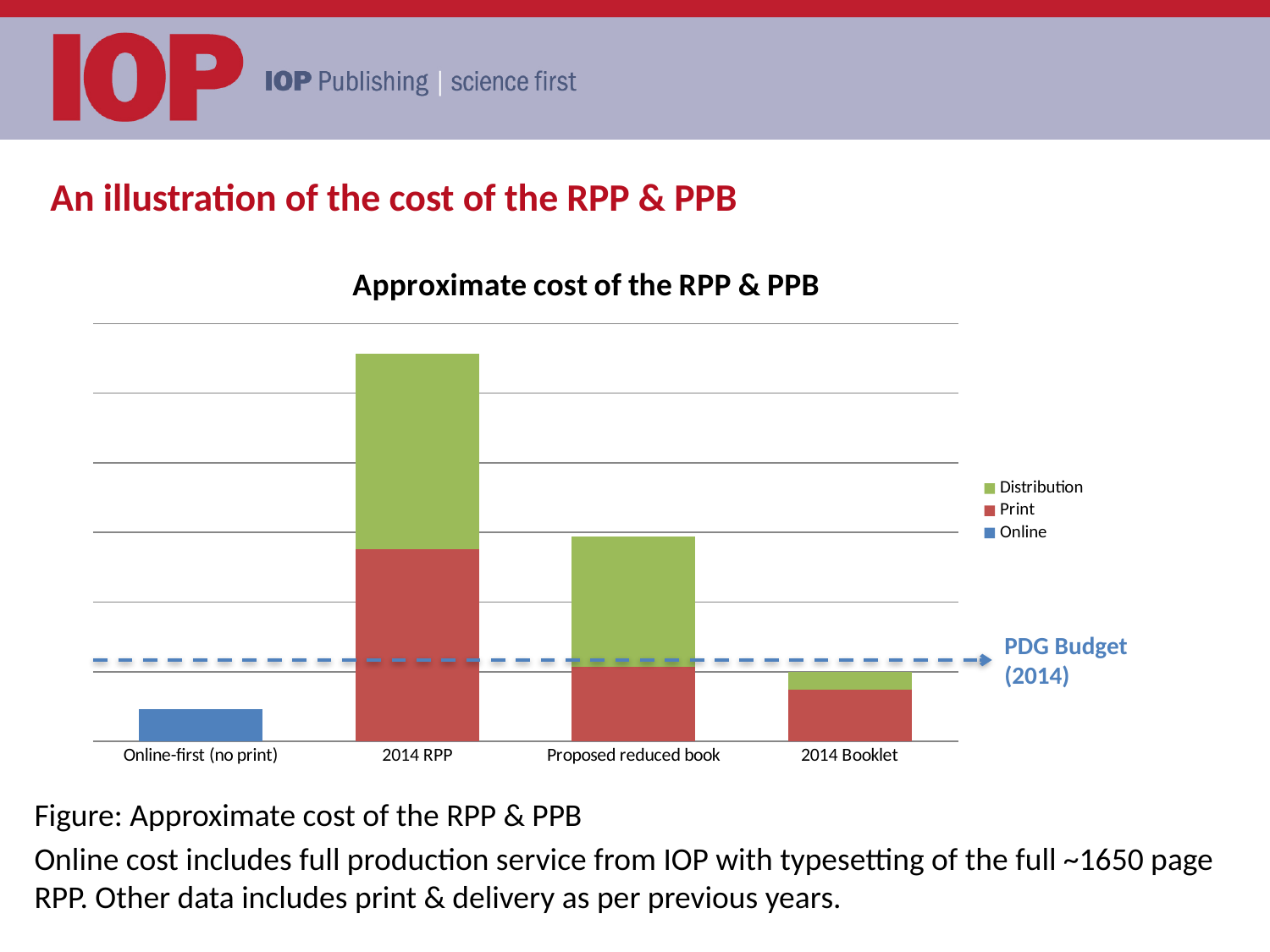
Which category has the highest total cost? 2014 RPP Which category consists only of the Online series? Online-first (no print) How many series does the legend list? 3 What kind of chart is shown on the slide? Stacked bar chart What is the title of the chart? Approximate cost of the RPP & PPB Which has the larger total cost, Proposed reduced book or 2014 Booklet? Proposed reduced book How many categories are shown on the x axis? 4 Which series is shown in green? Distribution Which category has the lowest total cost? Online-first (no print) Which has the larger total cost, Online-first (no print) or 2014 Booklet? 2014 Booklet Which categories have total costs above the PDG Budget (2014) dashed line? 2014 RPP and Proposed reduced book